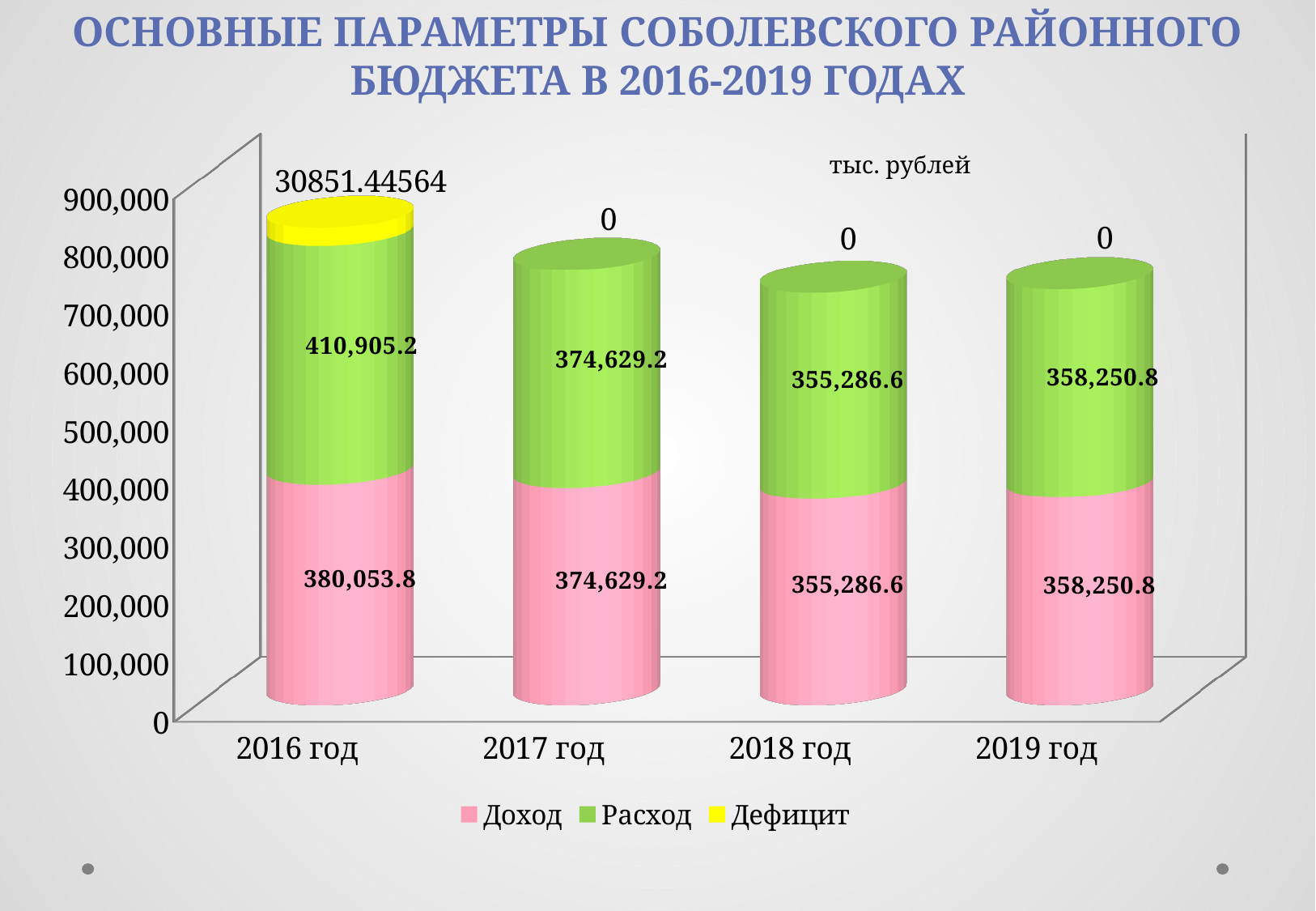
What is the difference between Расход and Доход in 2016 год? 30,851.4 What unit is stated on the chart? тыс. рублей What is the value of Расход for 2019 год? 358,250.8 What is the value of Дефицит for 2016 год? 30851.44564 In which year is Доход the lowest? 2018 год What is the total of the stacked bar for 2017 год? 749,258.4 In which year is Доход the highest? 2016 год What is the value of Расход for 2016 год? 410,905.2 What is the value of Доход for 2016 год? 380,053.8 How many series does the legend list? 3 Which is larger, Доход in 2017 год or Доход in 2019 год? Доход in 2017 год What is the value of Дефицит for 2018 год? 0